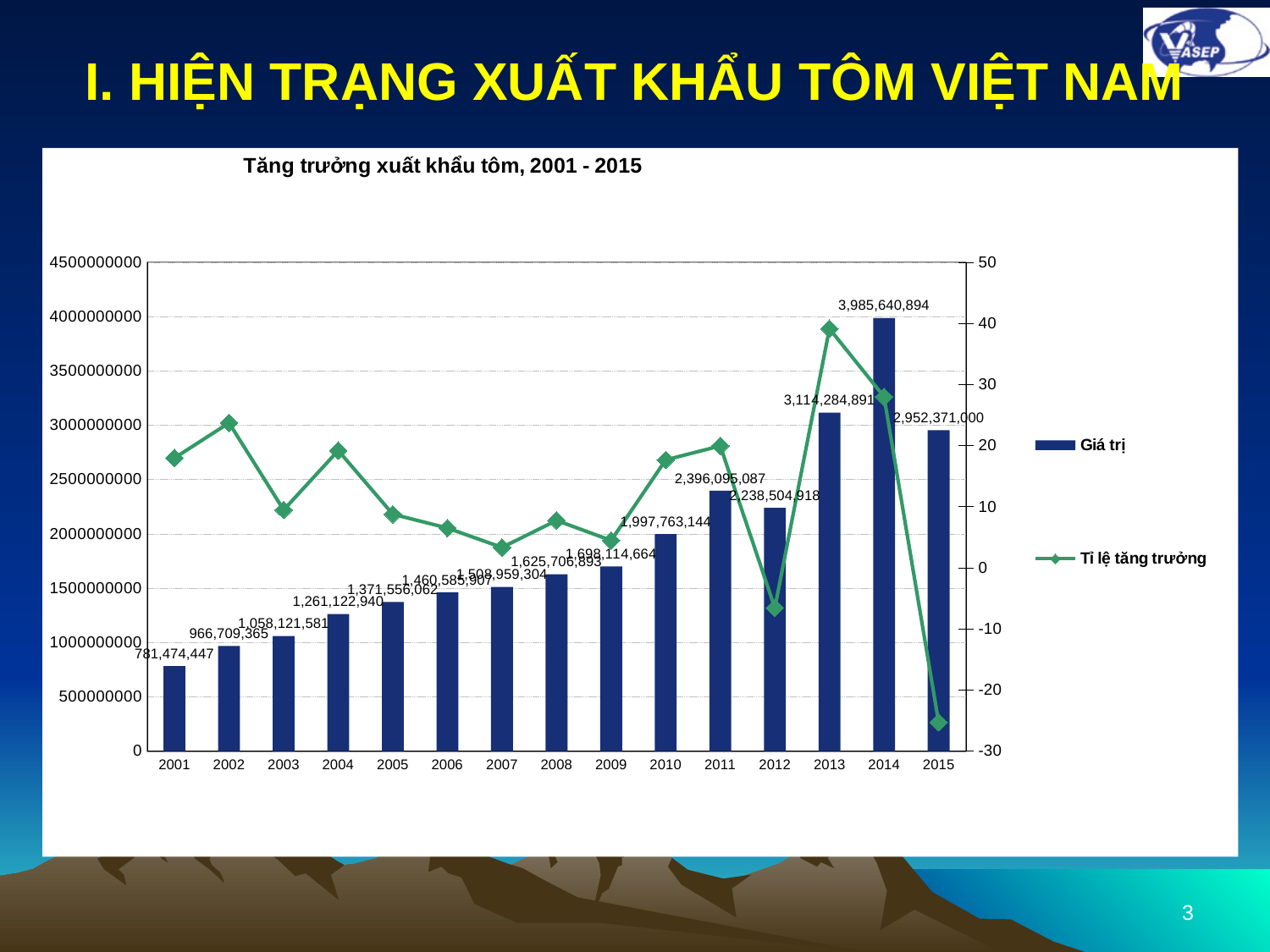
Which year has the highest Giá trị bar? 2014 What is the Giá trị value for 2013? 3,114,284,891 What is the Giá trị value for 2001? 781,474,447 Which year has the larger Giá trị value, 2011 or 2012? 2011 Is the Tỉ lệ tăng trưởng value for 2015 greater or less than -20? less How many series does the legend list? 2 What is the title of the chart? Tăng trưởng xuất khẩu tôm, 2001 - 2015 How many years are shown on the x axis of the chart? 15 Is the Tỉ lệ tăng trưởng value for 2013 greater or less than 30? greater Which year has the lowest Giá trị bar? 2001 What is the Giá trị value for 2014? 3,985,640,894 What is the difference between the Giá trị values for 2014 and 2013? 871,356,003